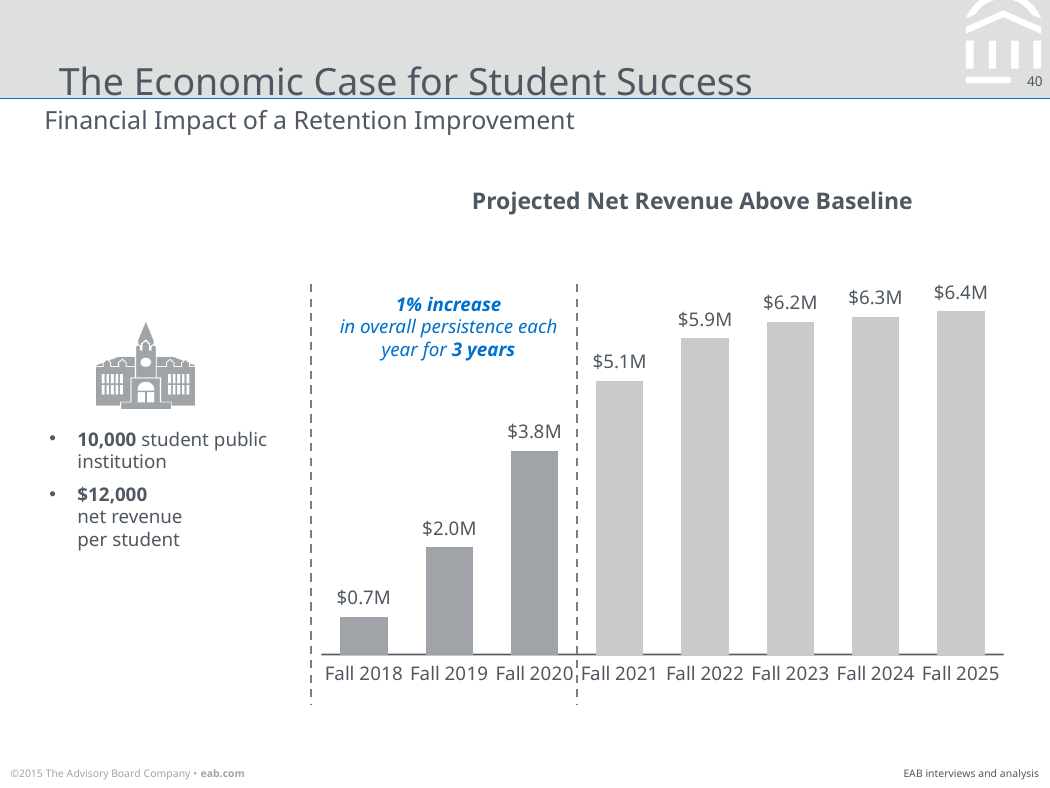
What is the projected net revenue above baseline for Fall 2023? $6.2M Do the projected net revenue values rise or fall from Fall 2018 to Fall 2025? Rise Which year has the highest projected net revenue above baseline? Fall 2025 What kind of chart is used to show the projected net revenue above baseline? Bar chart How many years are shown on the x axis of the chart? 8 What is the projected net revenue above baseline for Fall 2020? $3.8M What is the difference between the projected net revenue above baseline for Fall 2025 and Fall 2022? $0.5M What is the title of the chart? Projected Net Revenue Above Baseline Which is larger, the projected net revenue above baseline for Fall 2020 or for Fall 2021? Fall 2021 What is the difference between the projected net revenue above baseline for Fall 2021 and Fall 2019? $3.1M Which year has the lowest projected net revenue above baseline? Fall 2018 What is the projected net revenue above baseline for Fall 2018? $0.7M